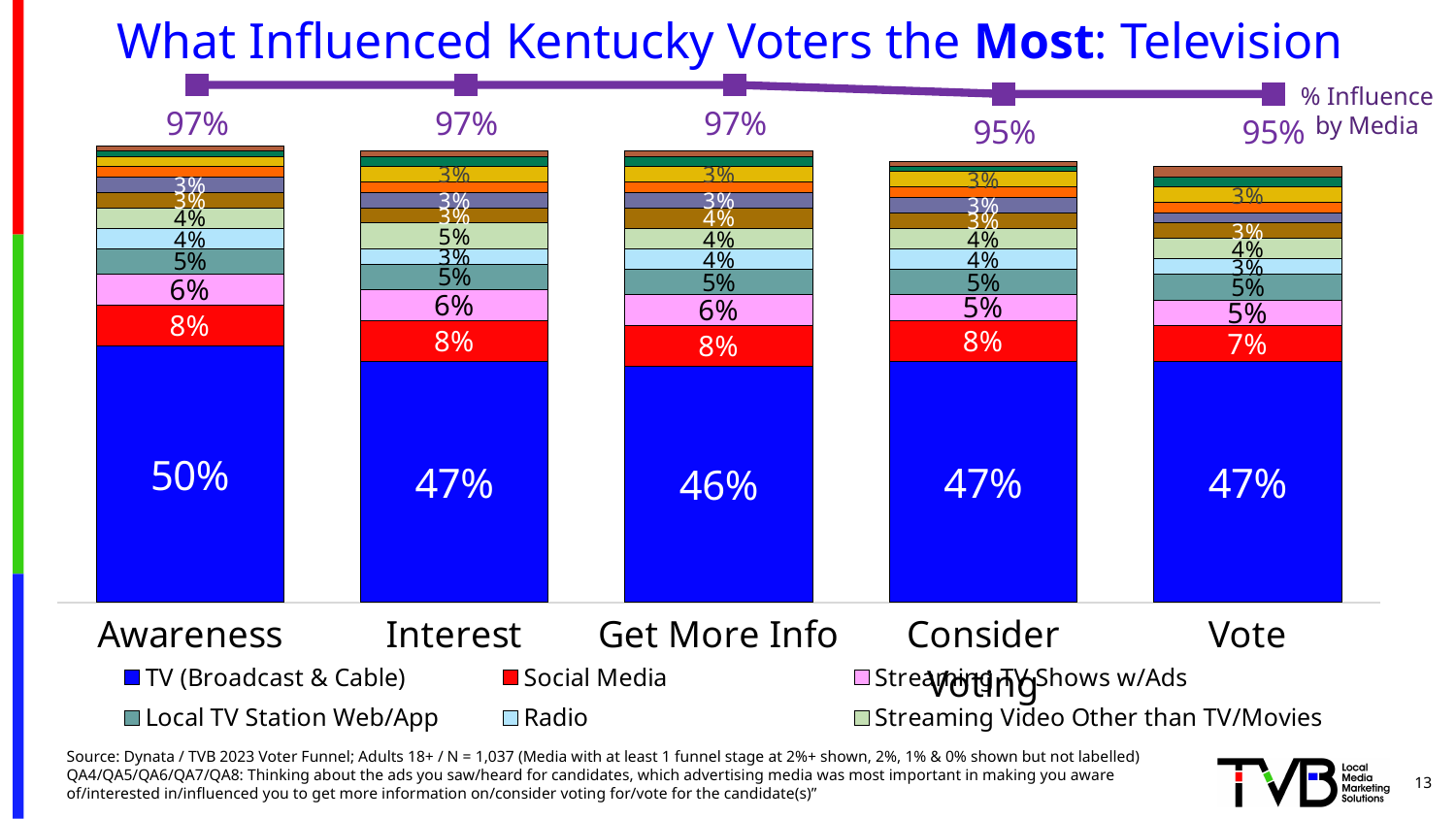
How many series does the legend list? 6 At which funnel stage is the TV (Broadcast & Cable) share highest? Awareness What is the Social Media value for the Vote stage? 7% What is the % Influence by Media value for the Consider stage? 95% What kind of chart is used to show the media shares by funnel stage? Stacked bar chart Which is larger, the Social Media value at Consider or at Vote? Consider At which funnel stage is the TV (Broadcast & Cable) share lowest? Get More Info How many funnel stages are shown on the x axis? 5 What is the difference between the TV (Broadcast & Cable) value at Awareness and at Interest? 3% Does the % Influence by Media line rise or fall from Awareness to Vote? Fall What is the TV (Broadcast & Cable) value for the Get More Info stage? 46% What is the TV (Broadcast & Cable) value for the Awareness stage? 50%